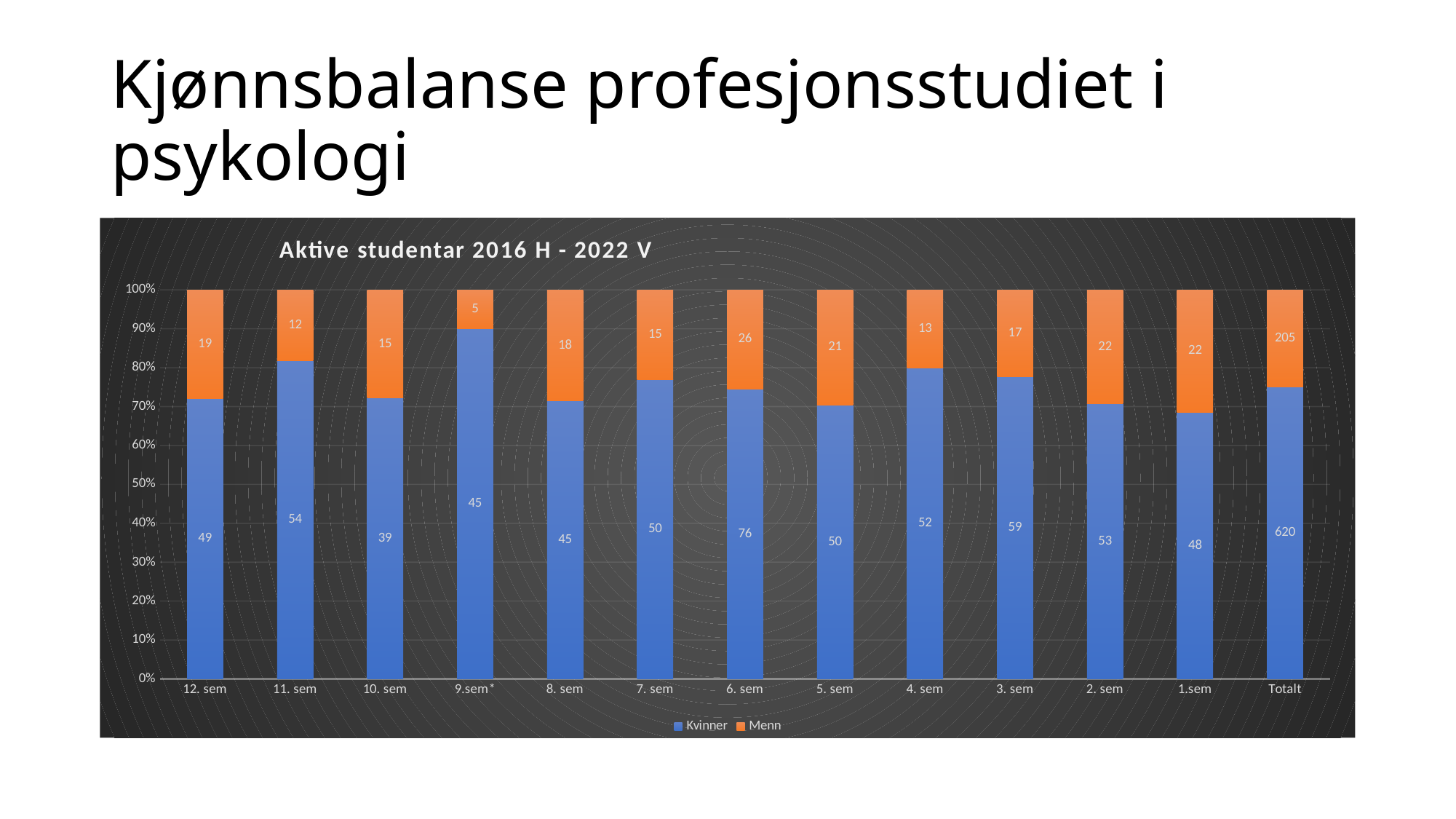
Which category has the highest value for Kvinner? Totalt What is the total of the stacked bar for Totalt (Kvinner plus Menn)? 825 Which is larger, the Kvinner value for 11. sem or for 10. sem? 11. sem What is the value for Kvinner in 6. sem? 76 How many categories are shown on the x axis? 13 What is the value for Menn in 9.sem*? 5 Which category has the lowest value for Menn? 9.sem* What is the title of the chart? Aktive studentar 2016 H - 2022 V Is the Kvinner share of the 9.sem* bar greater or less than 80%? greater What is the difference between the Kvinner and Menn values in 6. sem? 50 What is the value for Kvinner in the Totalt bar? 620 How many series does the legend list? 2